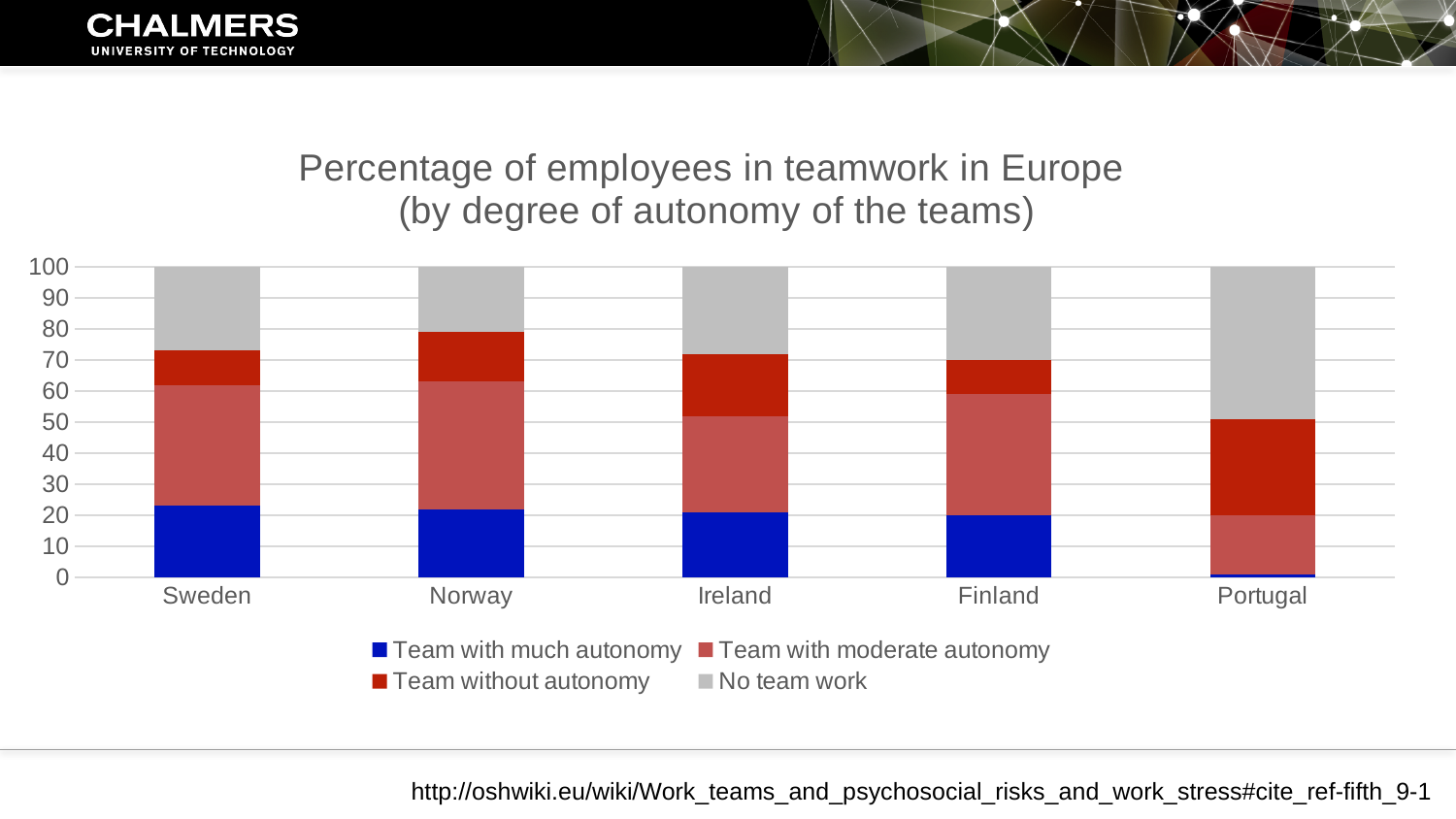
Which country has the largest 'No team work' segment? Portugal Is the 'Team with much autonomy' value for Portugal greater or less than 10? less What is the total of the stacked bar for Sweden? 100 Which is larger, the 'No team work' segment for Portugal or for Sweden? Portugal Which country has the smallest 'Team with much autonomy' segment? Portugal How many series does the chart legend list? 4 Is the 'No team work' value for Portugal greater or less than 40? greater What colour represents 'No team work' in the chart? Grey How many countries are shown on the x axis of the chart? 5 Is the 'Team with moderate autonomy' value for Ireland greater or less than 20? greater What kind of chart is shown on the slide? Stacked bar chart Which country has the largest 'Team without autonomy' segment? Portugal